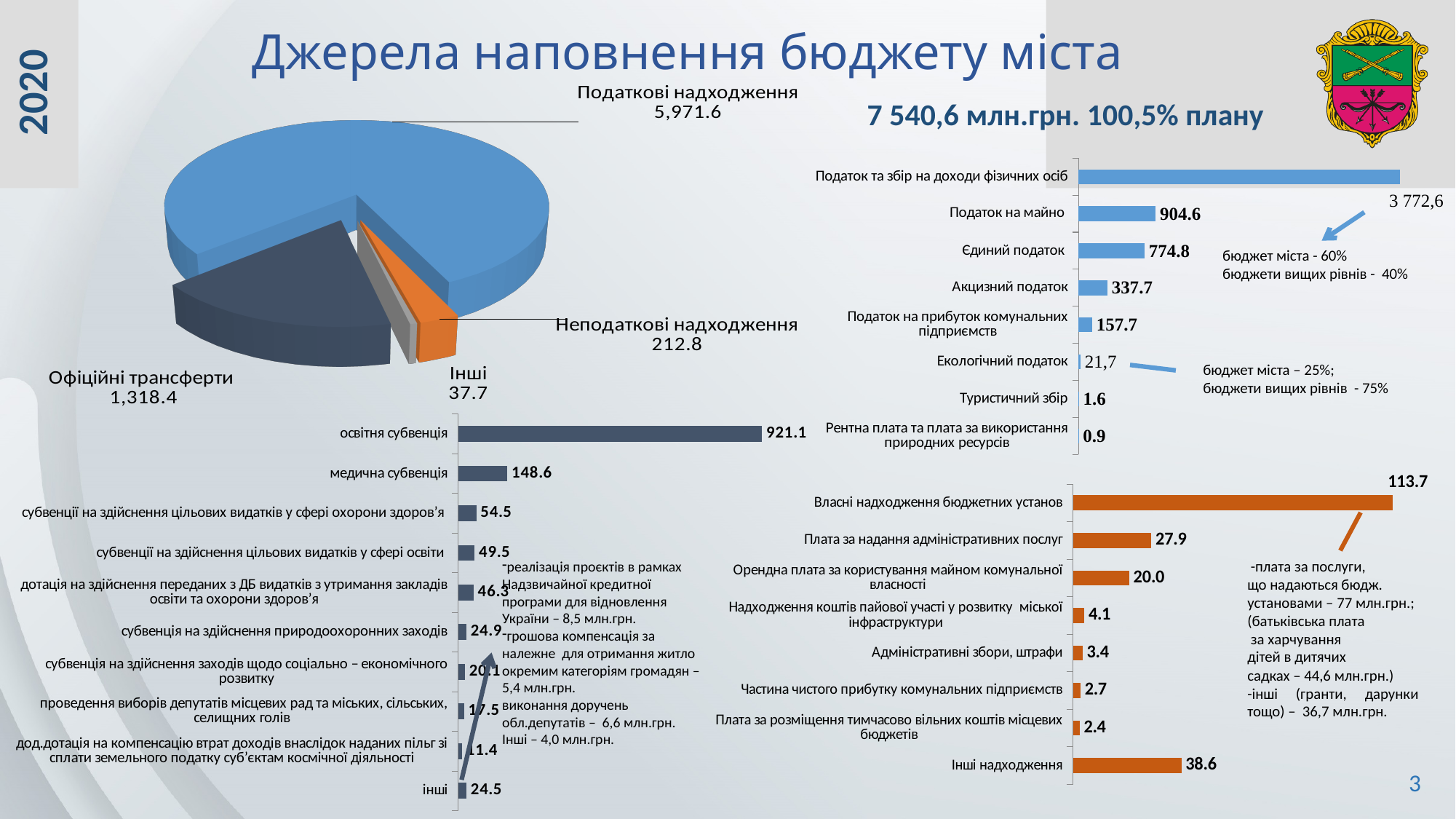
In the blue bar chart at the top right, which category has the highest value? Податок та збір на доходи фізичних осіб In the dark bar chart at the bottom left, what is the value for медична субвенція? 148.6 In the blue bar chart at the top right, which is larger: Акцизний податок or Податок на прибуток комунальних підприємств? Акцизний податок In the blue bar chart at the top right, what is the value for Податок на майно? 904.6 In the dark bar chart at the bottom left, what is the value for освітня субвенція? 921.1 In the pie chart at the top left, what is the value for Офіційні трансферти? 1,318.4 In the pie chart at the top left, what is the value for Податкові надходження? 5,971.6 In the orange bar chart at the bottom right, which category has the highest value? Власні надходження бюджетних установ In the blue bar chart at the top right, what is the difference between Податок на майно and Єдиний податок? 129.8 In the orange bar chart at the bottom right, what is the value for Інші надходження? 38.6 How many slices does the pie chart at the top left have? 4 In the pie chart at the top left, which category has the smallest slice? Інші